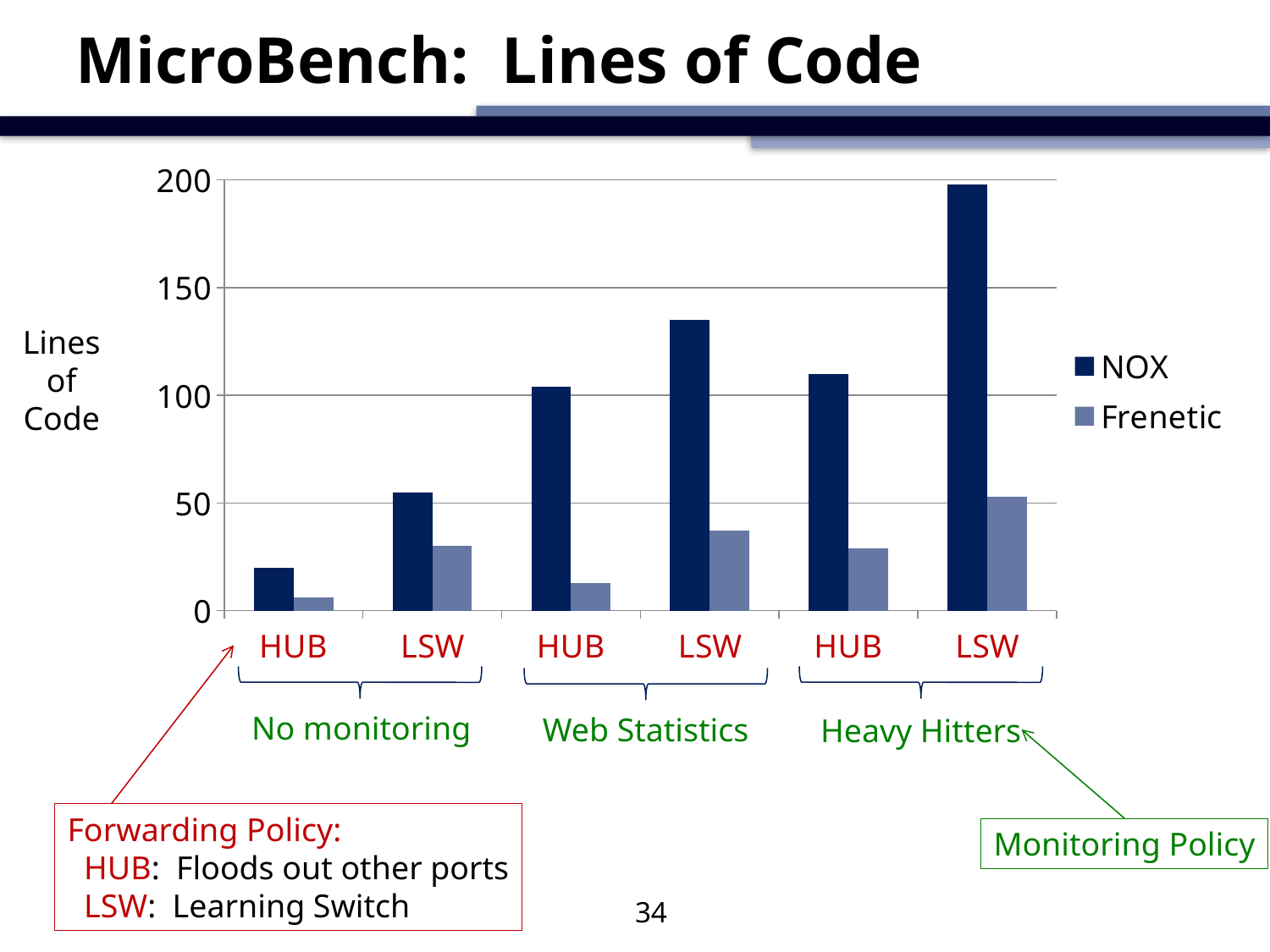
Is the NOX value for LSW under Heavy Hitters greater or less than 150? greater For which category is the NOX value lowest? HUB under No monitoring For which category is the Frenetic value lowest? HUB under No monitoring How many bar groups (HUB/LSW categories) are plotted along the x axis? 6 What kind of chart is shown on the slide? bar chart What is the label on the vertical axis? Lines of Code Which is larger for LSW under Web Statistics, the NOX value or the Frenetic value? NOX Is the Frenetic value for LSW under Web Statistics greater or less than 50? less Which series are listed in the legend? NOX and Frenetic How many series does the legend list? 2 Is the NOX value for LSW under Web Statistics greater or less than 150? less For which category is the NOX value highest? LSW under Heavy Hitters